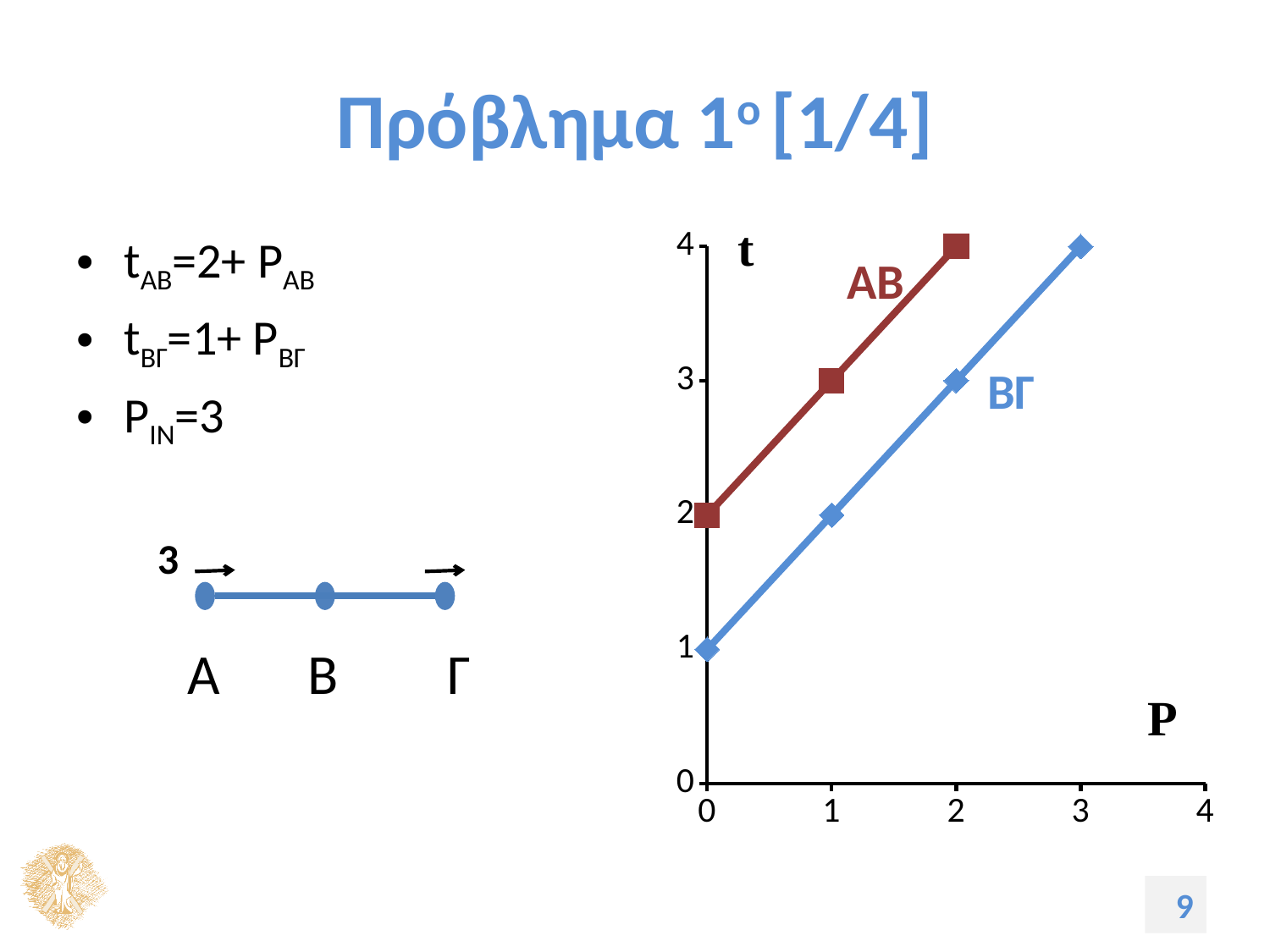
What is the value of t for the AB series at P = 0? 2 How many data points are plotted for the AB series? 3 What is the value of t for the AB series at P = 2? 4 What kind of chart is shown on the slide? line chart What is the difference between the t values of AB and ΒΓ at P = 2? 1 How many data points are plotted for the ΒΓ series? 4 At P = 1, which series has the higher t value, AB or ΒΓ? AB Does t rise or fall as P increases for the AB series? rise What is the value of t for the ΒΓ series at P = 0? 1 What is the value of t for the ΒΓ series at P = 3? 4 What label is shown on the vertical axis of the chart? t How many series are plotted on the chart? 2